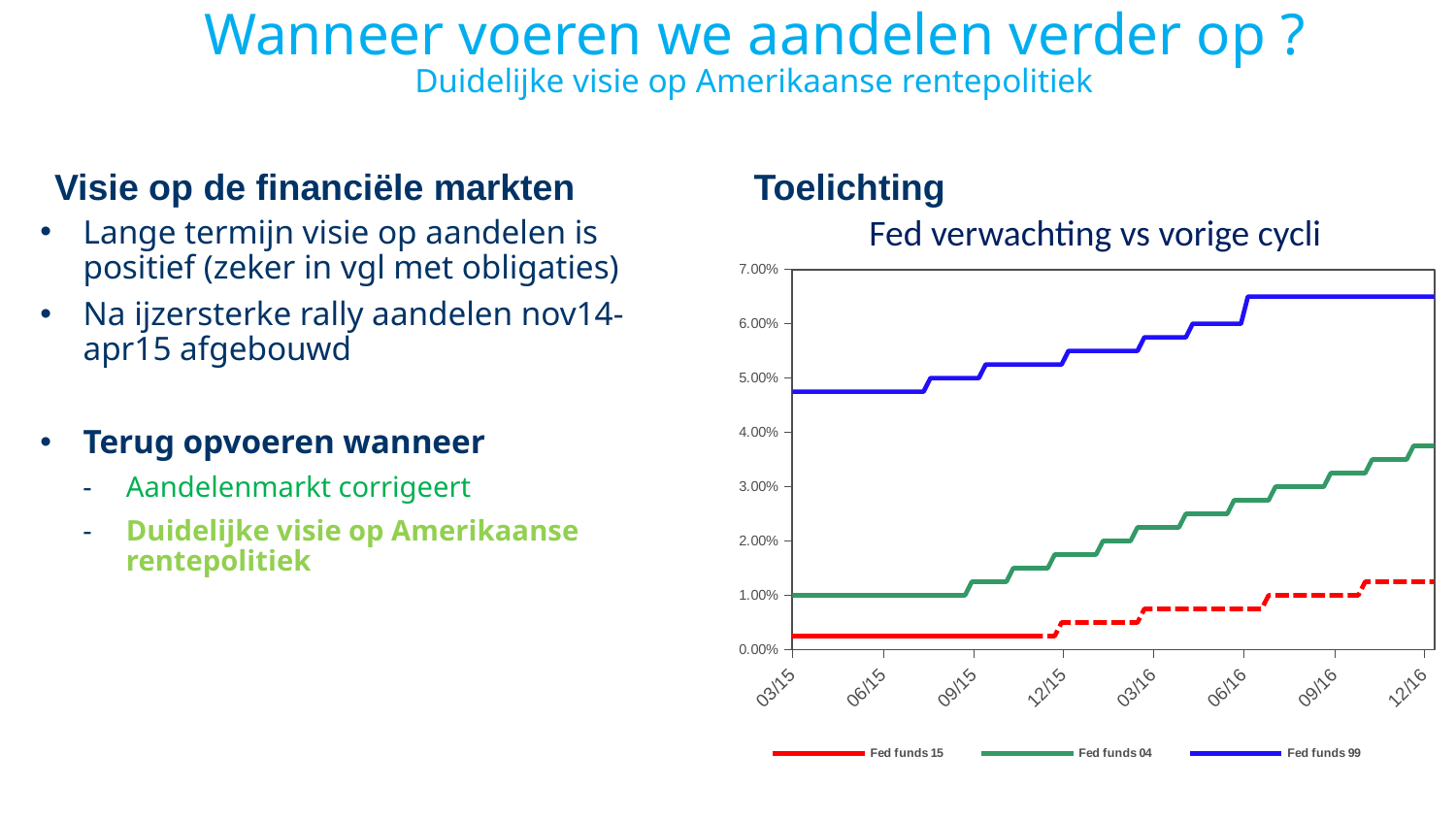
How many date labels are shown on the x axis of the chart? 8 What kind of chart is shown on the slide? line chart Which series is drawn in blue in the chart? Fed funds 99 What is the title of the chart on the slide? Fed verwachting vs vorige cycli Is the value of Fed funds 04 at 12/16 greater or less than 3.00%? greater How many series does the chart legend list? 3 Do the values of Fed funds 04 rise or fall from 03/15 to 12/16? rise Which series has the lowest value at 12/16? Fed funds 15 Is the value of Fed funds 99 at 12/16 greater or less than 6.00%? greater Which series has the highest value at 12/16? Fed funds 99 Is the value of Fed funds 15 at 03/15 greater or less than 1.00%? less